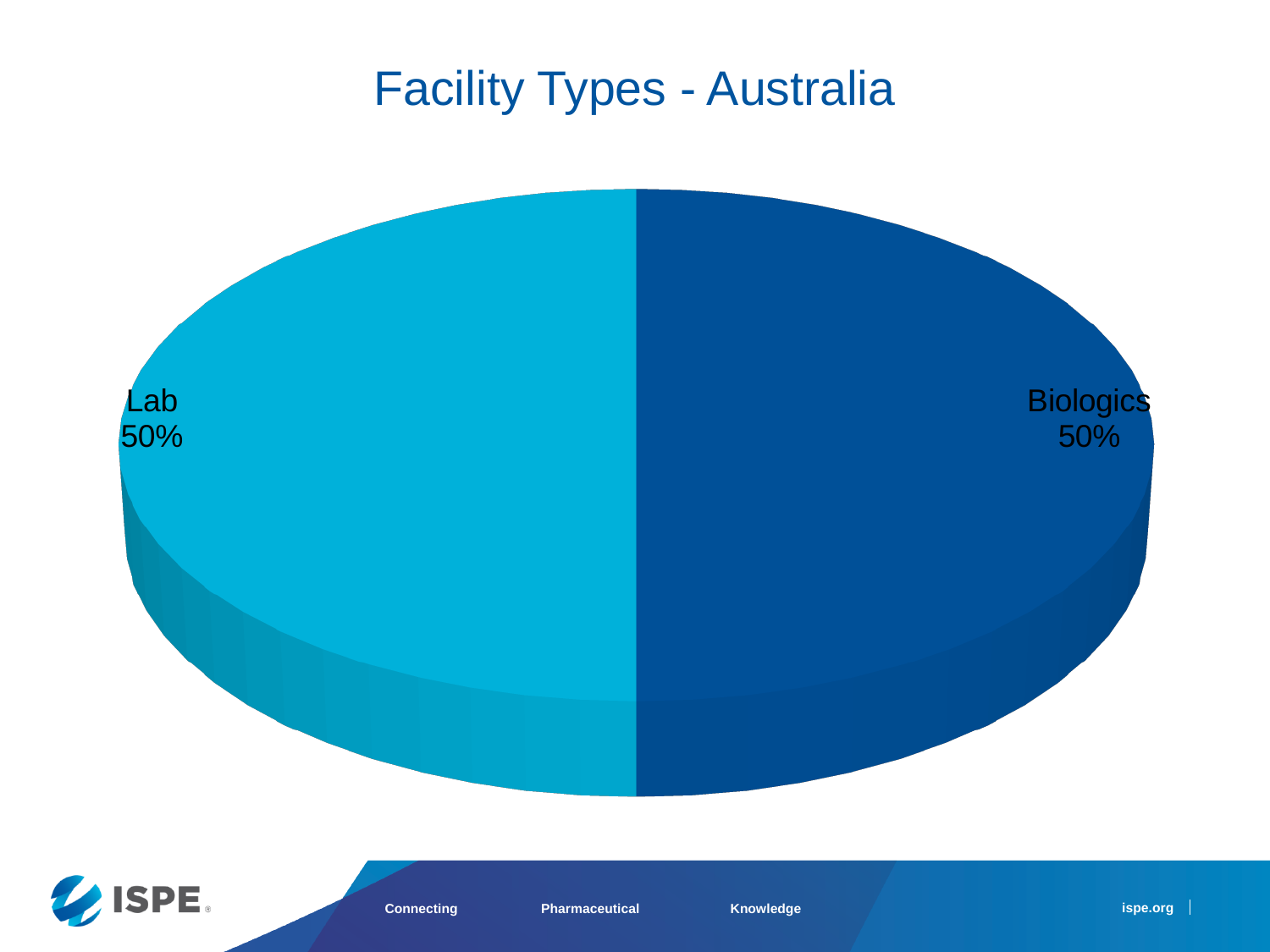
What is the difference between the Lab share and the Biologics share? 0% What is the title of the chart? Facility Types - Australia What share of the pie does Lab represent? 50% What is the combined share of Lab and Biologics? 100% What share of the pie does Biologics represent? 50% How many slices does the pie chart have? 2 What kind of chart is shown on the slide? pie chart Is the share for Lab greater or less than 40%? greater Which slice is shown in the darker blue colour? Biologics Is the share for Biologics greater or less than 60%? less